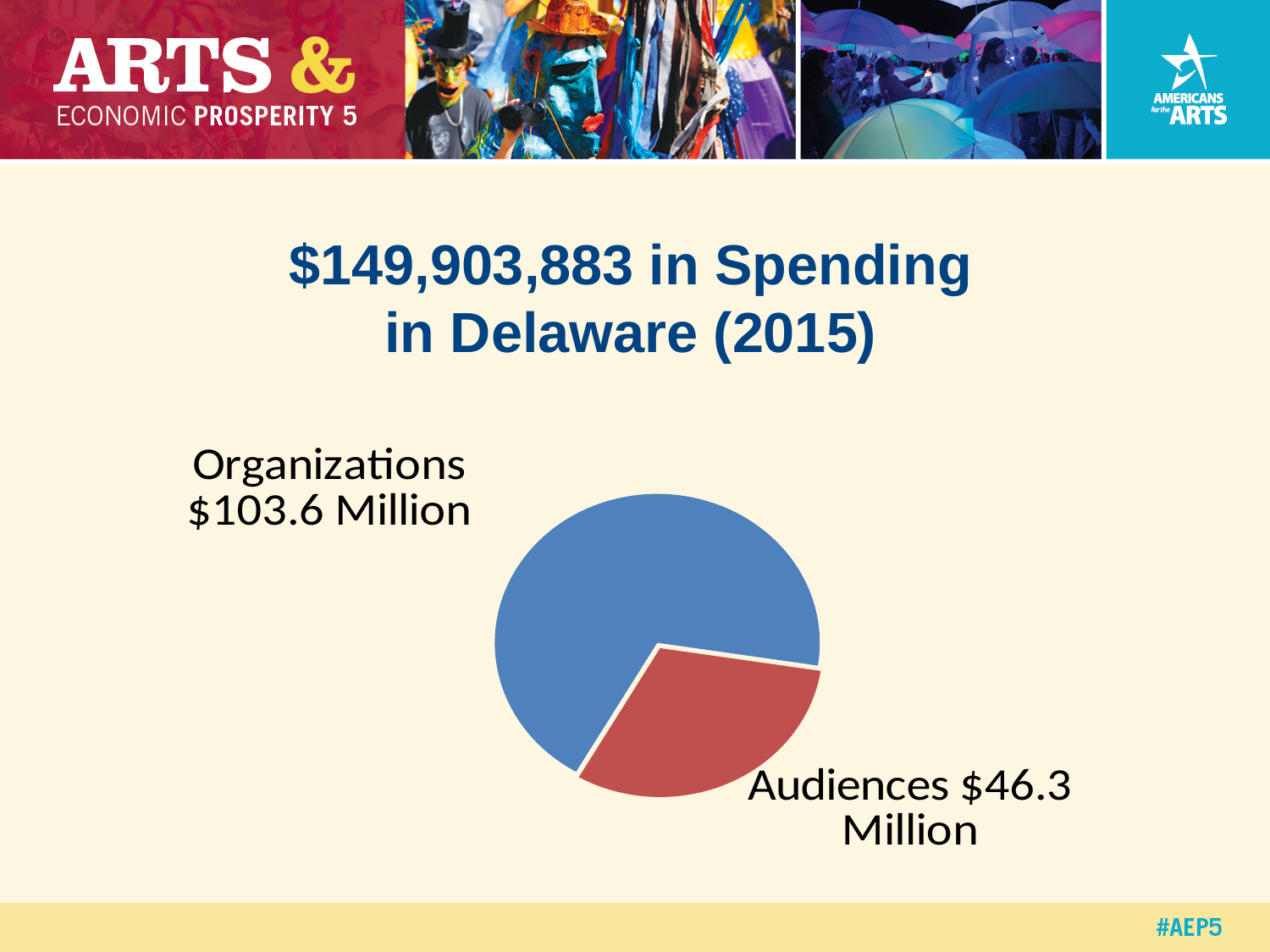
Which category has the largest slice of the pie chart? Organizations What is the spending value for Organizations in the pie chart? $103.6 Million Which category has the smallest slice of the pie chart? Audiences How much more did Organizations spend than Audiences, according to the pie chart labels? $57.3 Million What is the combined spending of Organizations and Audiences shown in the pie chart labels? $149.9 Million Which year does the spending shown in the pie chart refer to? 2015 How many slices does the pie chart have? 2 What colour is the Audiences slice in the pie chart? Red What is the title of the slide containing the pie chart? $149,903,883 in Spending in Delaware (2015) Which is larger, spending by Organizations or spending by Audiences? Organizations What type of chart is shown on the slide? Pie chart What is the spending value for Audiences in the pie chart? $46.3 Million